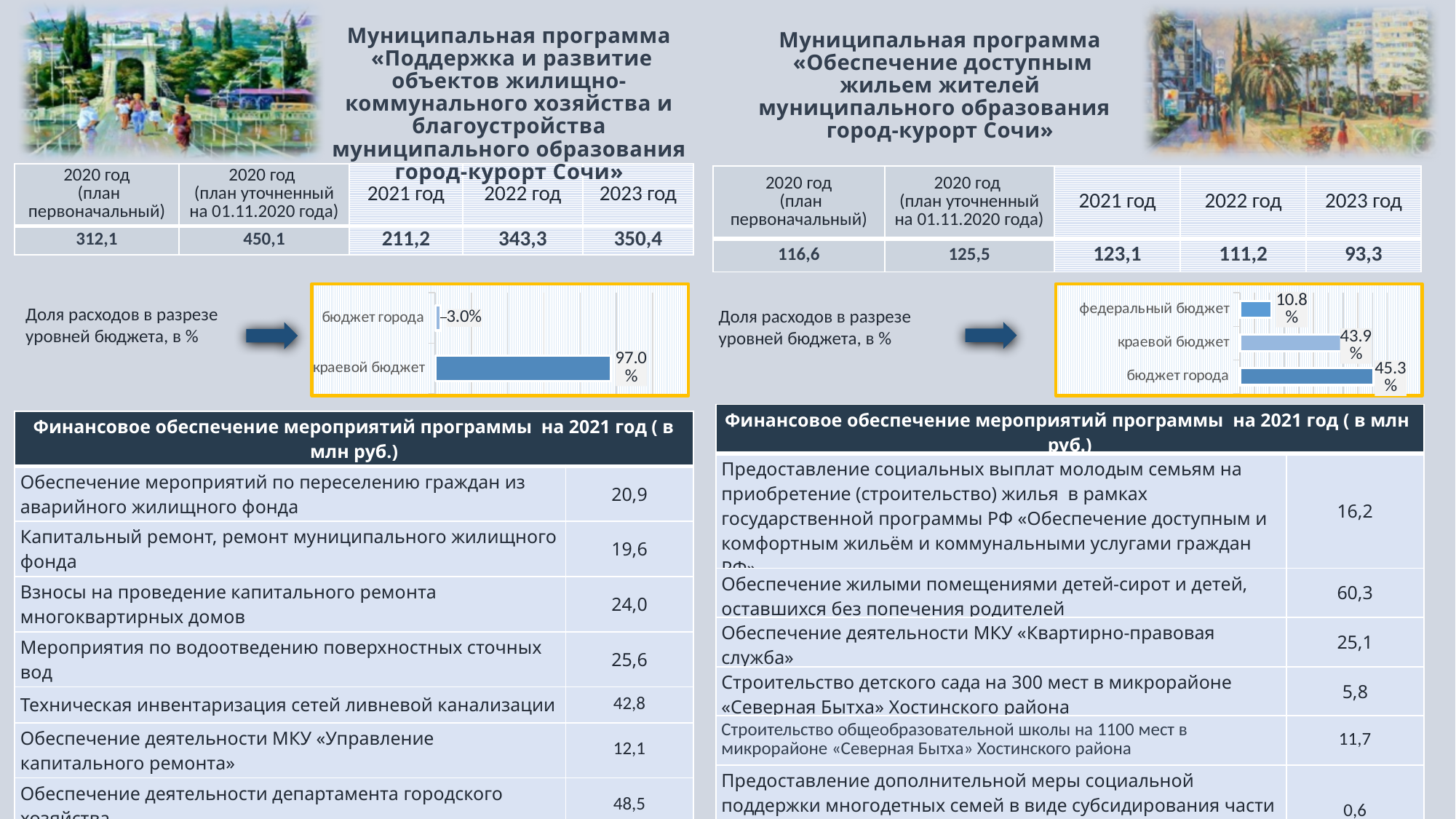
In the right chart, what is the value for краевой бюджет? 43.9% What kind of chart is the left chart? bar chart How many categories does the right chart show? 3 In the left chart, what is the value for краевой бюджет? 97.0% In the right chart, what is the value for федеральный бюджет? 10.8% In the left chart, what is the difference between краевой бюджет and бюджет города? 94.0% In the left chart, which category has the highest value? краевой бюджет In the left chart, what is the value for бюджет города? 3.0% In the right chart, what is the difference between бюджет города and федеральный бюджет? 34.5% In the right chart, which category has the lowest value? федеральный бюджет In the right chart, what is the value for бюджет города? 45.3% How many categories does the left chart show? 2